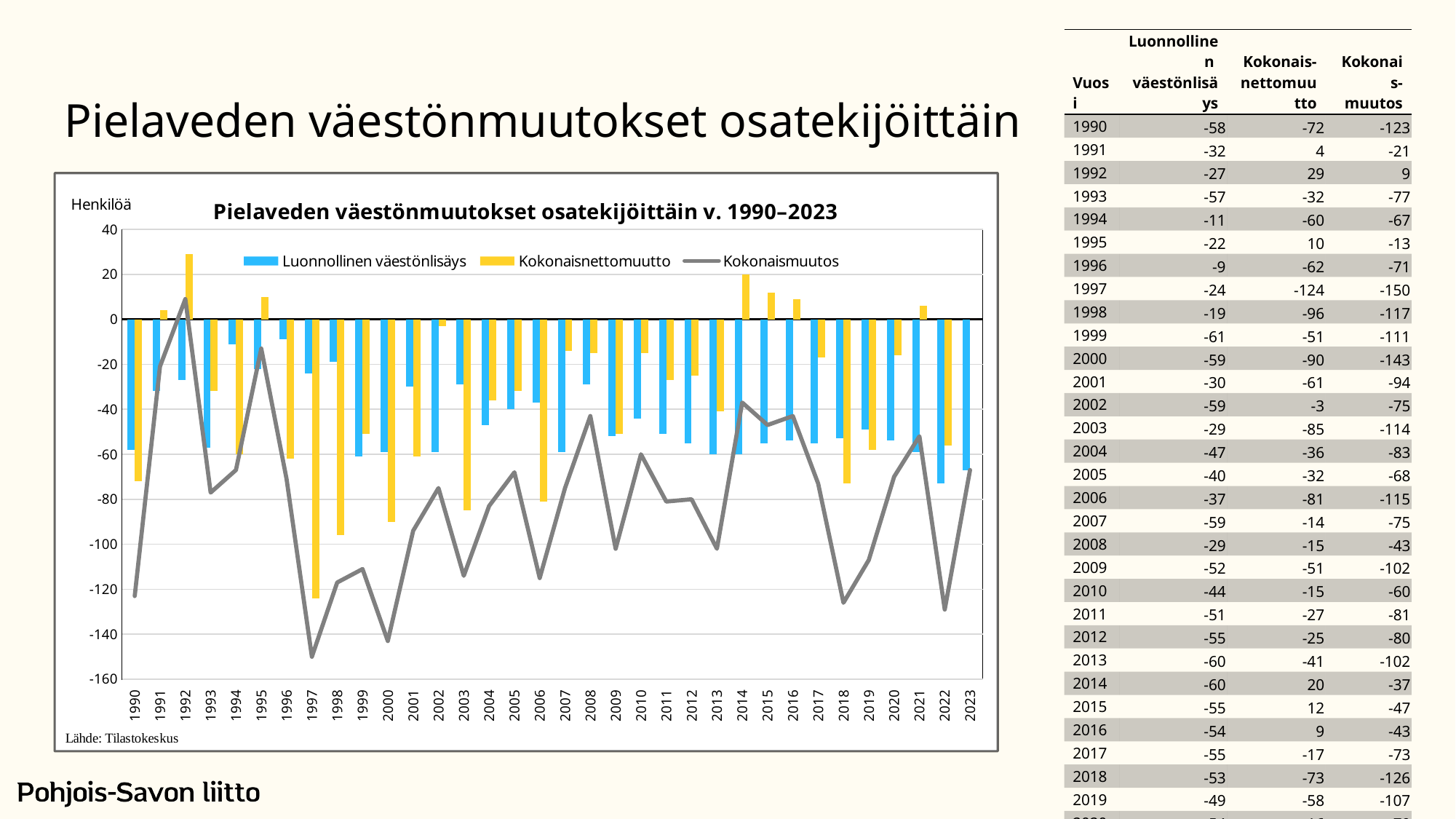
How many years are shown on the x axis of the chart? 34 What kind of chart is shown on the slide? bar and line chart What is the Kokonaismuutos value for 1997? -150 How many series does the chart legend list? 3 Which series is drawn as a grey line in the chart? Kokonaismuutos Is the Kokonaismuutos value for 2000 greater or less than -120? less In which year is Kokonaismuutos at its highest? 1992 What is the source cited below the chart? Tilastokeskus Which year has the larger Luonnollinen väestönlisäys value, 1994 or 1999? 1994 What is the Kokonaisnettomuutto value for 1992? 29 In which year is Kokonaismuutos at its lowest? 1997 What is the difference between the Kokonaismuutos values for 1990 and 1991? 102